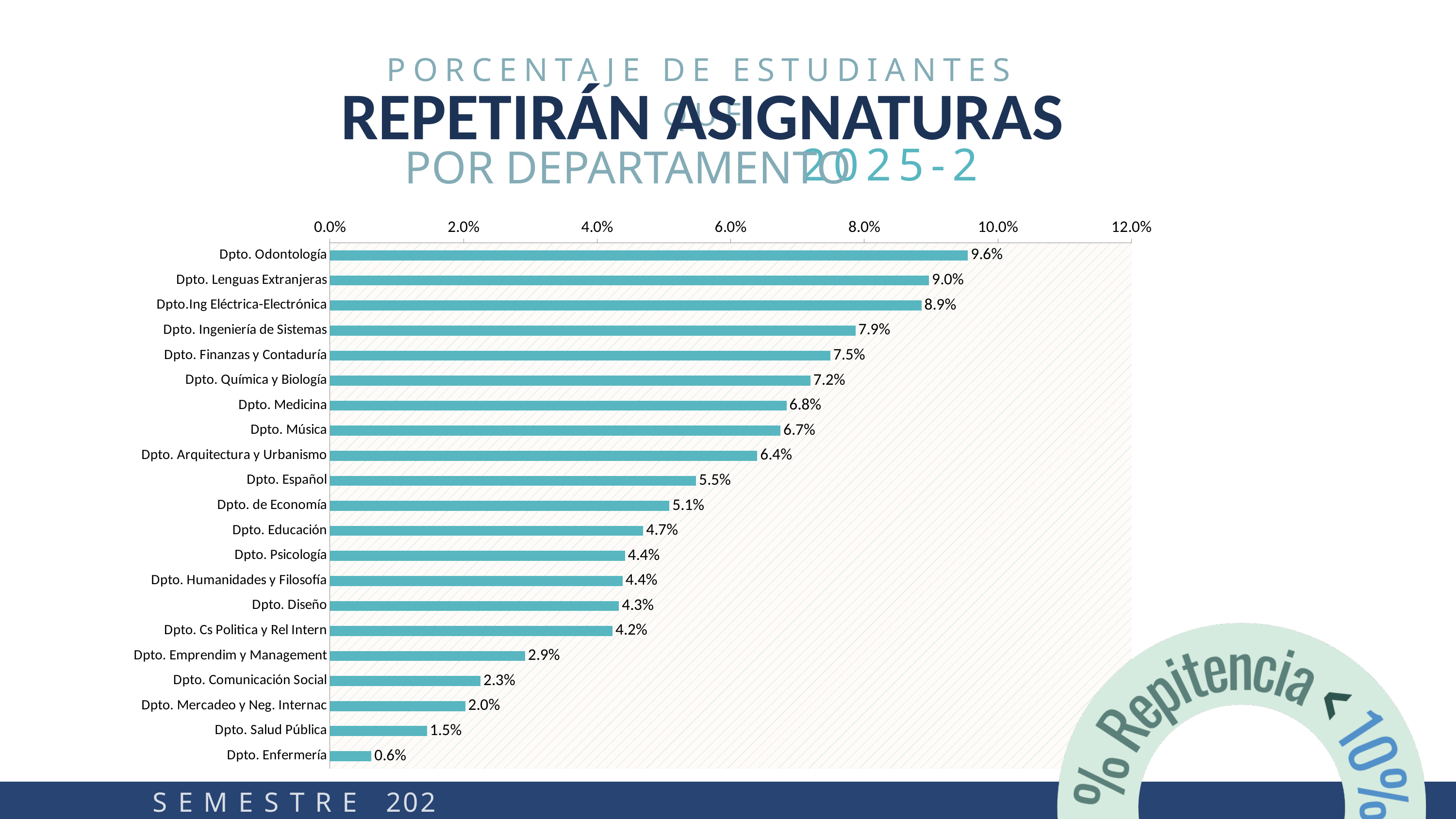
What is the difference between the values for Dpto. Lenguas Extranjeras and Dpto. Ingeniería de Sistemas? 1.1% Is the value for Dpto. Finanzas y Contaduría greater or less than 6.0%? greater What is the maximum value shown on the horizontal axis? 12.0% Which department has the highest percentage? Dpto. Odontología What kind of chart is shown on the slide? Bar chart What is the value for Dpto. Comunicación Social? 2.3% Which department has the lowest percentage? Dpto. Enfermería Which is larger, the value for Dpto. Química y Biología or the value for Dpto. Educación? Dpto. Química y Biología What is the value for Dpto. Odontología? 9.6% How many departments are shown in the chart? 21 What is the difference between the values for Dpto. Español and Dpto. Salud Pública? 4.0% What is the value for Dpto. Medicina? 6.8%